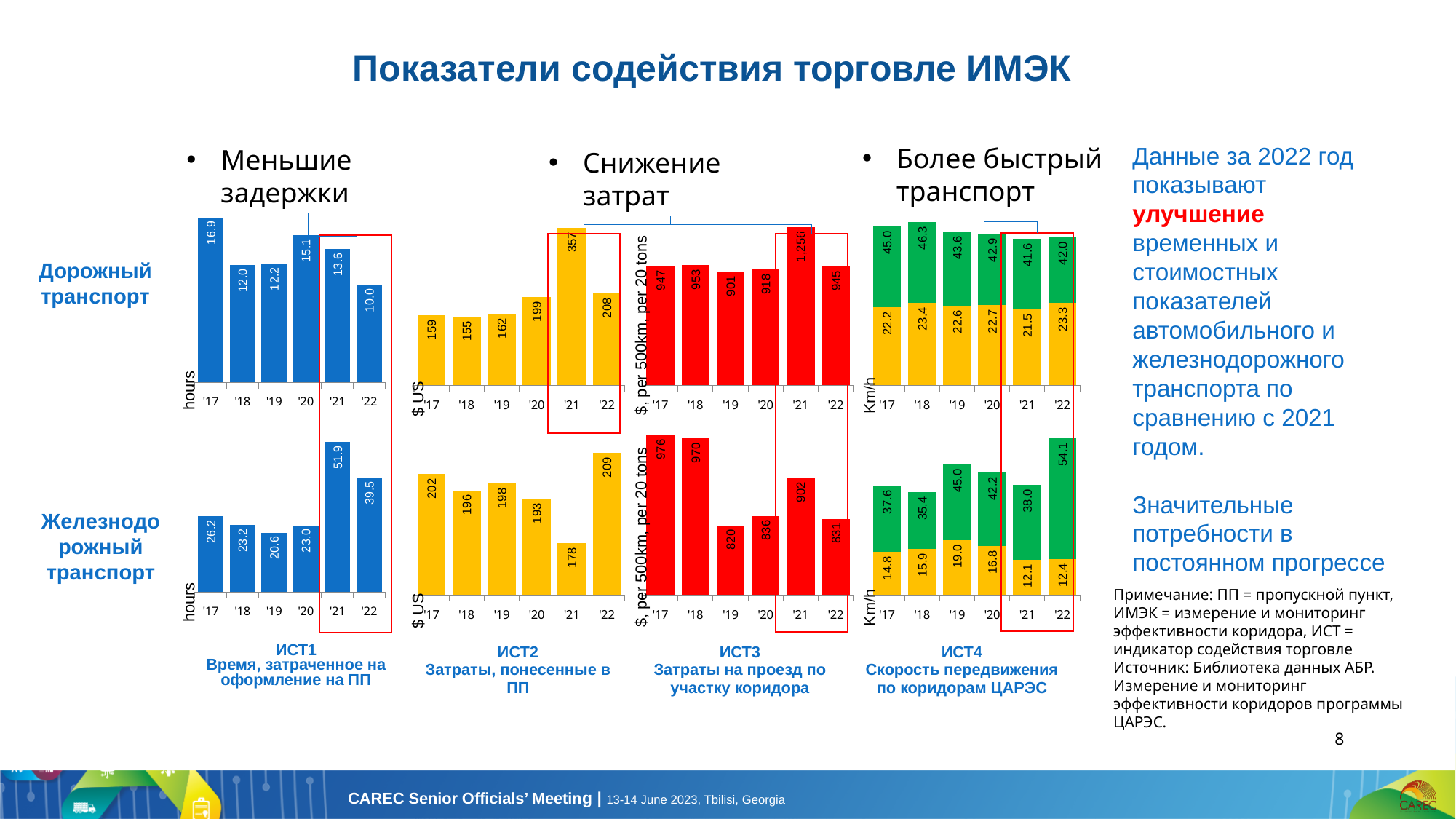
In the ИСТ1 chart for Дорожный транспорт (road transport), what is the value for '22? 10.0 In the ИСТ1 chart for Железнодорожный транспорт (rail transport), what is the difference between the '21 and '22 values? 12.4 In the ИСТ2 chart for Дорожный транспорт (road transport), what is the value for '21? 357 How many years are shown on the x axis of the ИСТ1 chart for Дорожный транспорт (road transport)? 6 In the ИСТ3 chart for Железнодорожный транспорт (rail transport), what is the difference between the '21 and '22 values? 71 In the ИСТ2 chart for Железнодорожный транспорт (rail transport), which year has the lowest value? '21 What unit is shown on the y axis of the ИСТ4 charts? Km/h What kind of chart is the ИСТ2 chart for Дорожный транспорт (road transport)? bar chart In the ИСТ3 chart for Железнодорожный транспорт (rail transport), which is larger, the value for '17 or the value for '19? '17 In the ИСТ1 chart for Железнодорожный транспорт (rail transport), which year has the highest value? '21 In the ИСТ4 chart for Железнодорожный транспорт (rail transport), what is the total of the stacked bar for '22? 66.5 In the ИСТ3 chart for Дорожный транспорт (road transport), what is the value for '21? 1,256